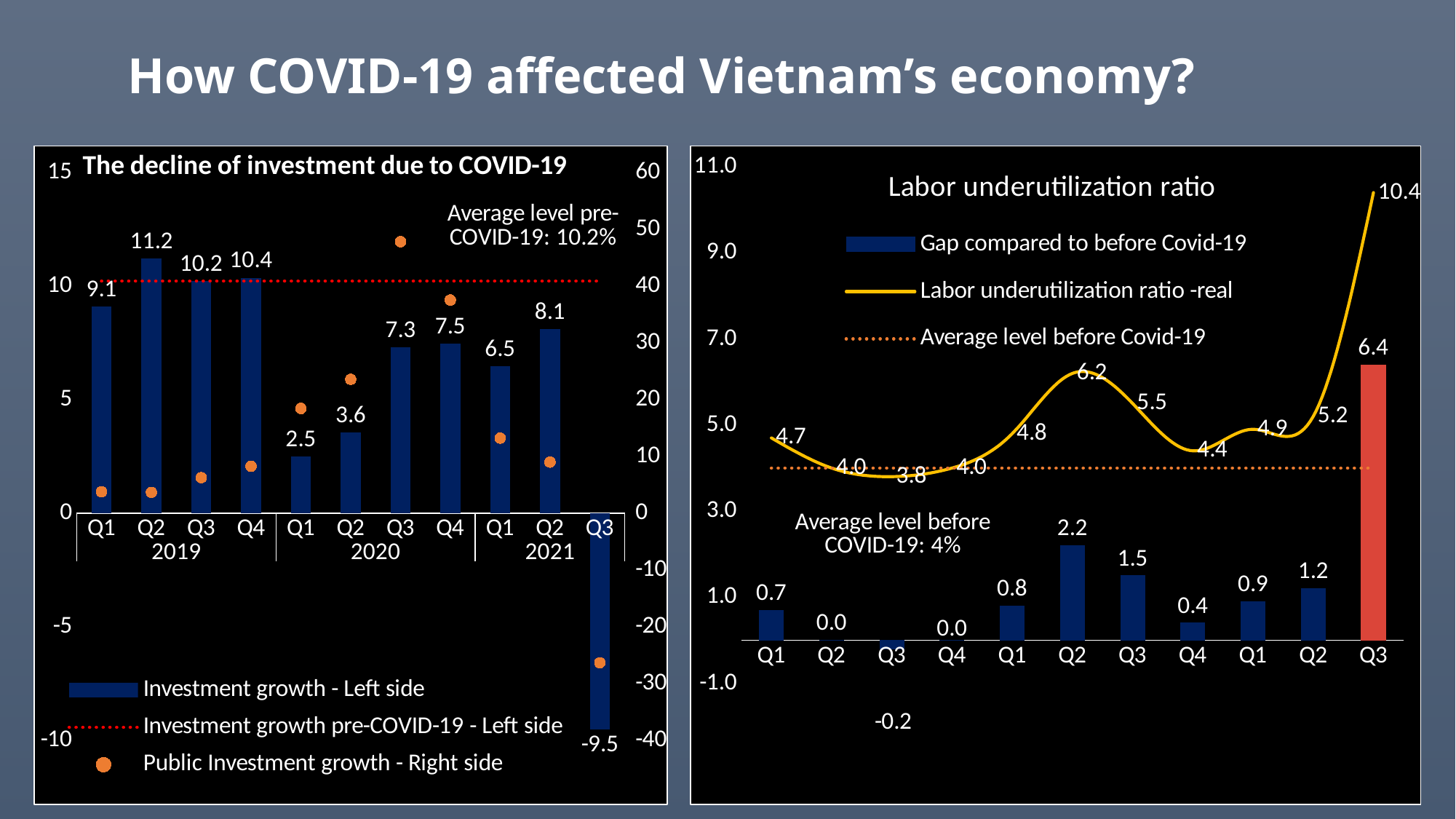
In the 'Labor underutilization ratio' chart, what is the largest value of the 'Gap compared to before Covid-19' bars? 6.4 In the chart 'The decline of investment due to COVID-19', is the Public Investment growth dot for Q3 2020 greater or less than 40 on the right axis? greater In the chart 'The decline of investment due to COVID-19', which quarter has the lowest investment growth? Q3 2021 In the chart 'The decline of investment due to COVID-19', what is the investment growth value for Q2 2019? 11.2 In the 'Labor underutilization ratio' chart, what is the real labor underutilization ratio at the rightmost Q3? 10.4 In the chart 'The decline of investment due to COVID-19', how many series does the legend list? 3 In the chart 'The decline of investment due to COVID-19', what average level pre-COVID-19 is stated for investment growth? 10.2% What kind of chart is the 'Labor underutilization ratio' chart? Combined bar and line chart In the chart 'The decline of investment due to COVID-19', which quarter has the highest investment growth? Q2 2019 In the 'Labor underutilization ratio' chart, what is the difference between the peak ratio of 6.2 and the following quarter's ratio of 5.5? 0.7 In the chart 'The decline of investment due to COVID-19', what is the difference between investment growth in Q2 2019 and Q1 2020? 8.7 In the chart 'The decline of investment due to COVID-19', how many quarters are plotted on the x axis? 11